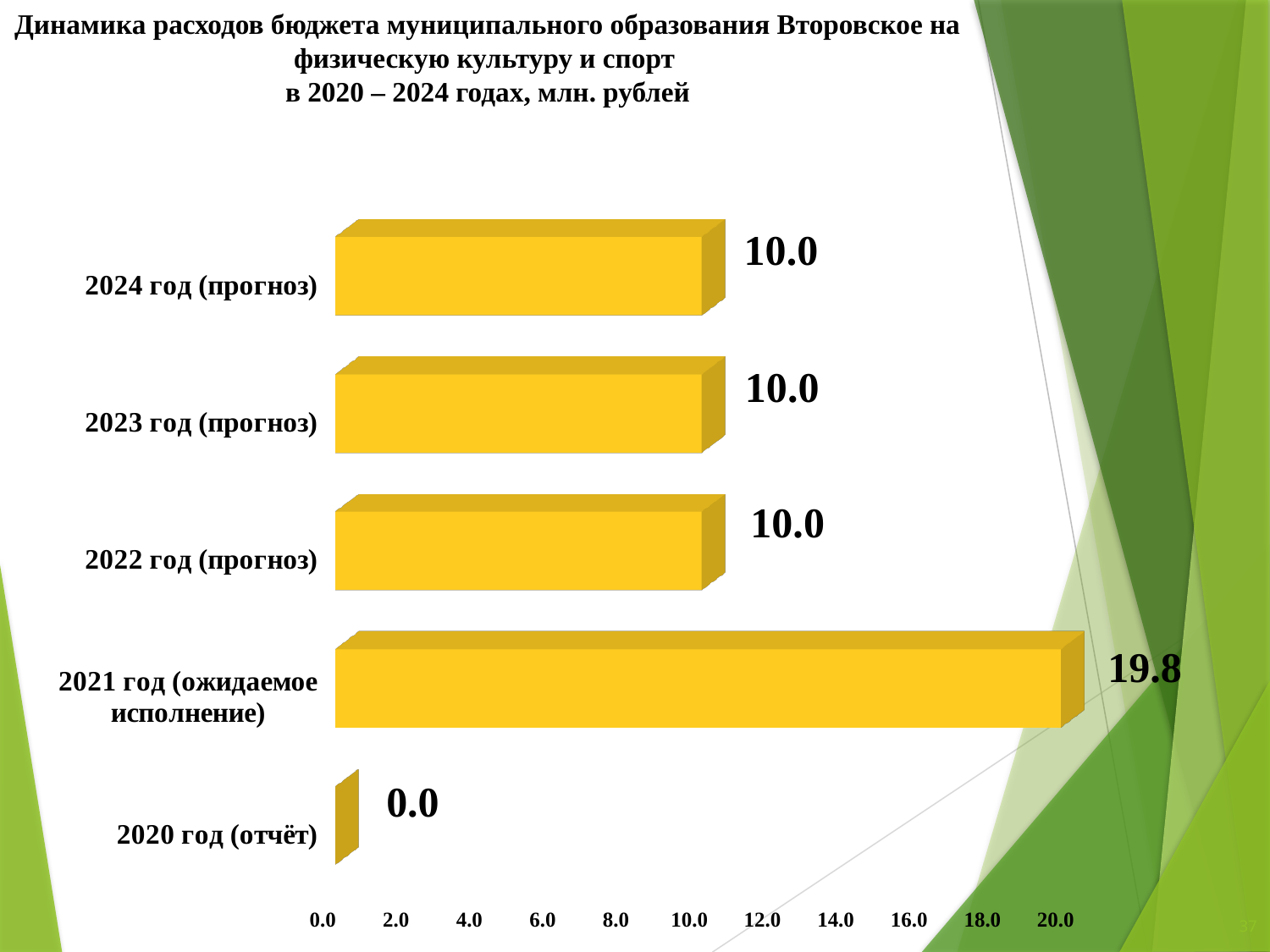
Is the value for 2021 год (ожидаемое исполнение) greater or less than 18.0? greater What colour are the bars in the chart? yellow Which is larger, the value for 2021 год (ожидаемое исполнение) or the value for 2023 год (прогноз)? 2021 год (ожидаемое исполнение) What is the value for 2020 год (отчёт)? 0.0 Which category has the lowest value? 2020 год (отчёт) What is the value for 2024 год (прогноз)? 10.0 What is the value for 2021 год (ожидаемое исполнение)? 19.8 Which category has the highest value? 2021 год (ожидаемое исполнение) What is the highest tick value shown on the horizontal axis? 20.0 How many categories are shown in the chart? 5 What is the difference between the values for 2021 год (ожидаемое исполнение) and 2022 год (прогноз)? 9.8 What kind of chart is shown on the slide? bar chart